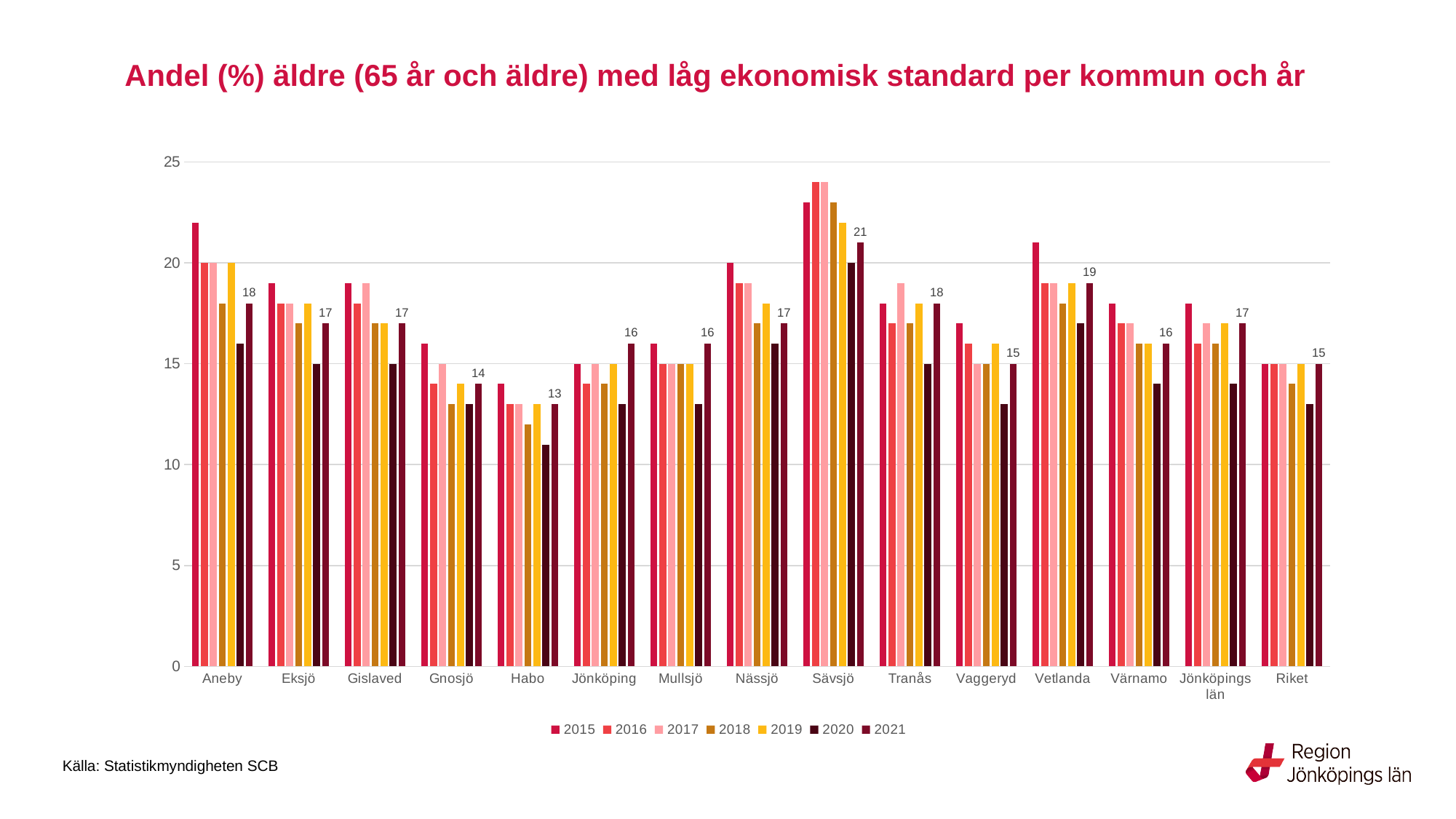
How many categories are shown on the x axis? 15 Which category has the lowest 2021 value? Habo Is the 2016 value for Sävsjö greater or less than 20? greater How many series does the legend list? 7 Which municipality has the highest 2021 value? Sävsjö Is the 2018 value for Habo greater or less than 15? less What is the difference between the 2021 values for Sävsjö and Habo? 8 What is the 2021 value for Sävsjö? 21 What kind of chart is shown on the slide? Bar chart Which has the larger 2021 value, Vetlanda or Gnosjö? Vetlanda What is the 2021 value for Habo? 13 What is the 2021 value for Riket? 15